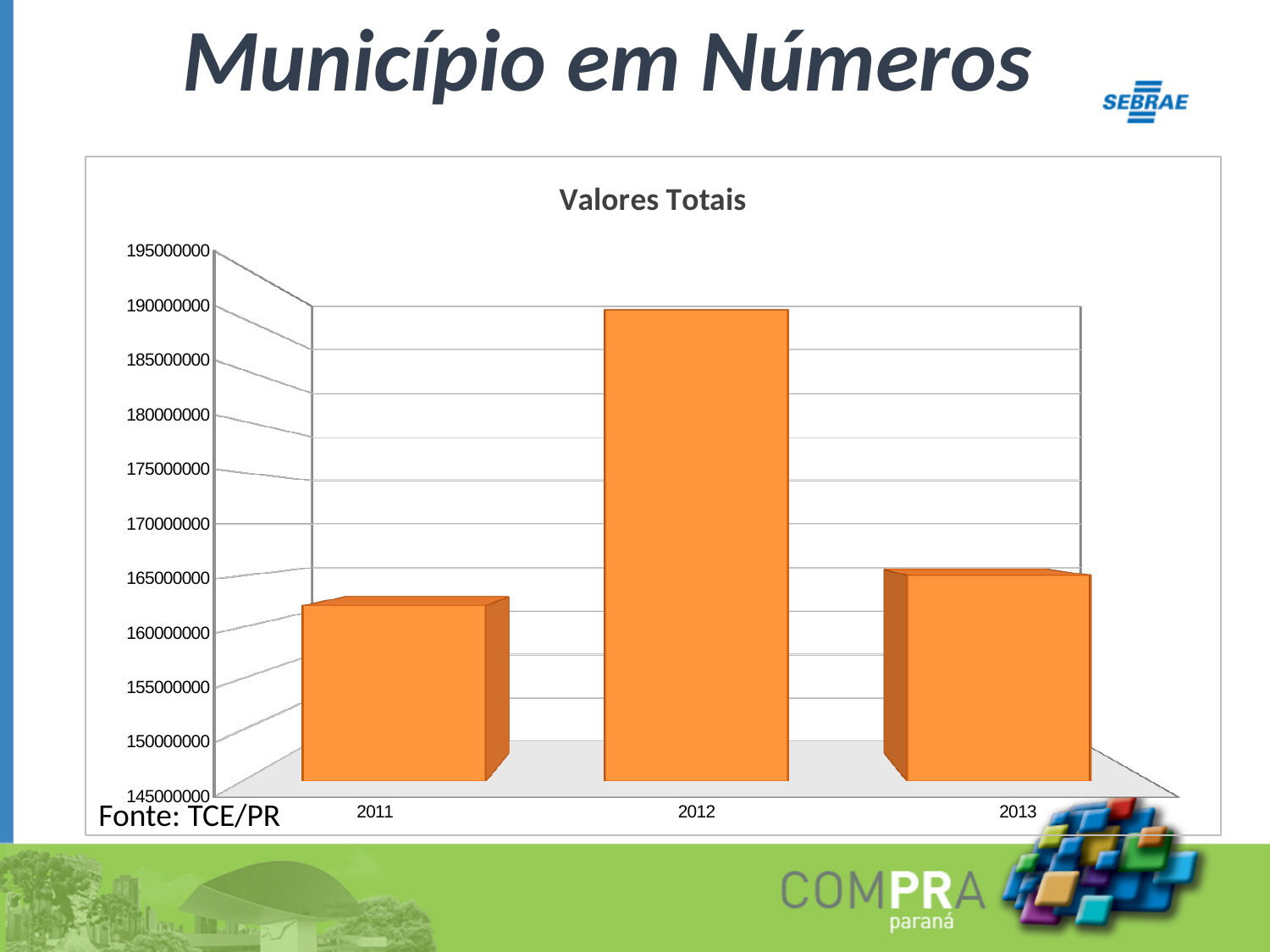
What kind of chart is shown on the slide? bar chart Which year has the lowest value in the chart? 2011 How many years are shown on the x axis of the chart? 3 Is the value for 2011 greater or less than 165000000? less Is the value for 2012 greater or less than 185000000? greater Which is larger, the value for 2011 or the value for 2013? 2013 Does the value rise or fall from 2011 to 2012? rise Which year has the highest value in the chart? 2012 Is the value for 2013 greater or less than 160000000? greater Which is larger, the value for 2012 or the value for 2013? 2012 What is the title of the chart? Valores Totais What source is cited below the chart? TCE/PR